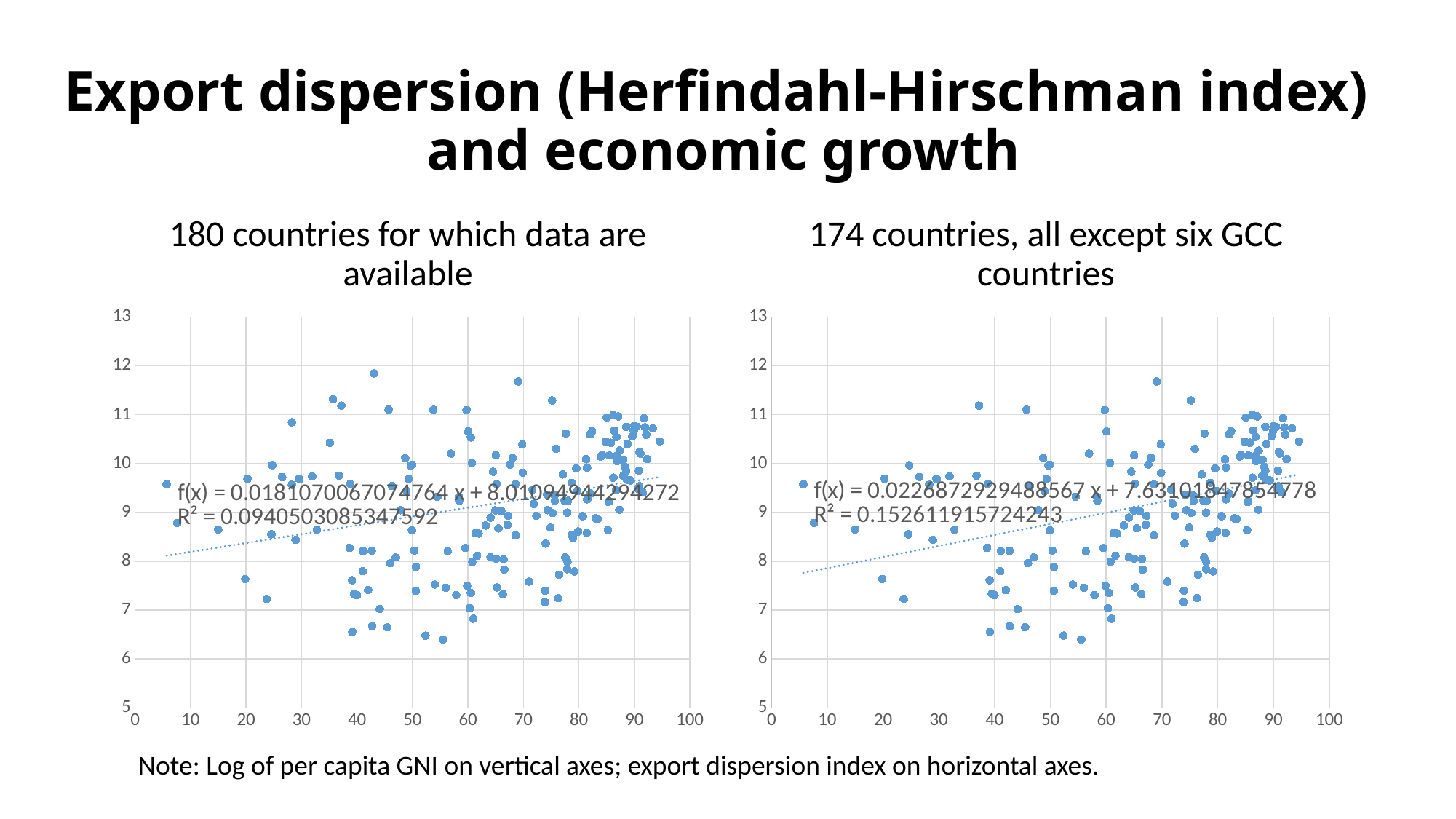
What kind of chart is the right chart titled "174 countries, all except six GCC countries"? scatter chart Which chart has the higher R² value, the left chart (180 countries) or the right chart (174 countries)? the right chart (174 countries) In the right chart (174 countries), does the dotted trend line rise or fall as the export dispersion index increases along the x axis? rise In the right chart (174 countries), what is the R² value printed on the chart? 0.152611915724243 In the left chart (180 countries), does the dotted trend line rise or fall along the x axis? rise In the right chart (174 countries), what is the intercept of the fitted line f(x)? 7.63101847854778 What kind of chart is the left chart titled "180 countries for which data are available"? scatter chart According to its title, how many countries are plotted in the left chart? 180 In the left chart (180 countries), what is the R² value printed on the chart? 0.0940503085347592 In the left chart (180 countries), what is the slope of the fitted line f(x)? 0.0181070067074764 According to the note on the slide, what is plotted on the vertical axes of the charts? Log of per capita GNI According to its title, how many countries are plotted in the right chart? 174